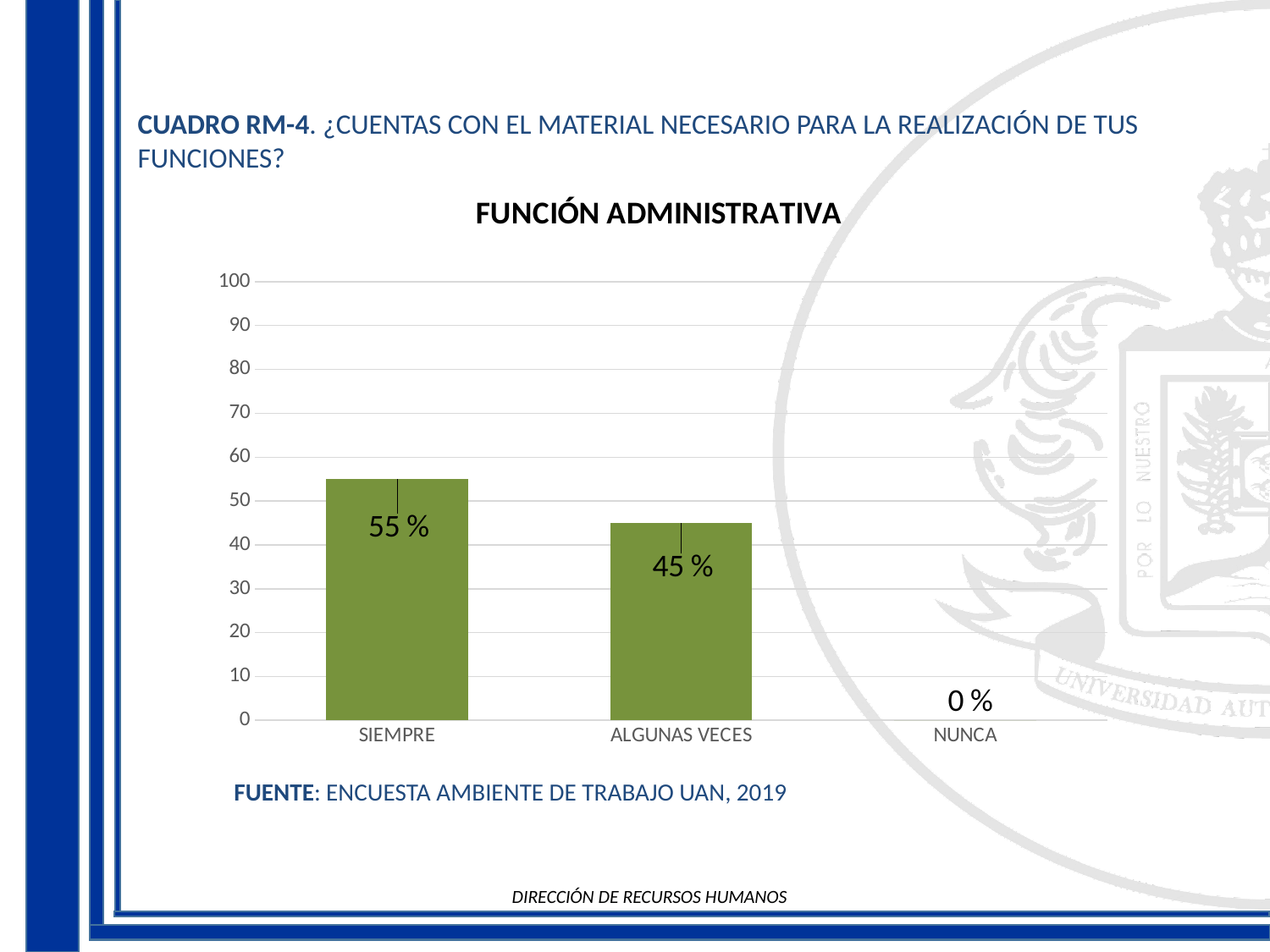
Is the value for ALGUNAS VECES greater or less than 50? less How many categories are shown on the x axis? 3 What is the value for SIEMPRE? 55 % What is the value for ALGUNAS VECES? 45 % Which category has the lowest value? NUNCA What is the difference between the values for SIEMPRE and ALGUNAS VECES? 10 % What is the title of the chart? FUNCIÓN ADMINISTRATIVA Which is larger, the value for SIEMPRE or the value for ALGUNAS VECES? SIEMPRE What is the value for NUNCA? 0 % Do the values rise or fall from left to right along the x axis? fall Which category has the highest value? SIEMPRE What kind of chart is shown on the slide? bar chart